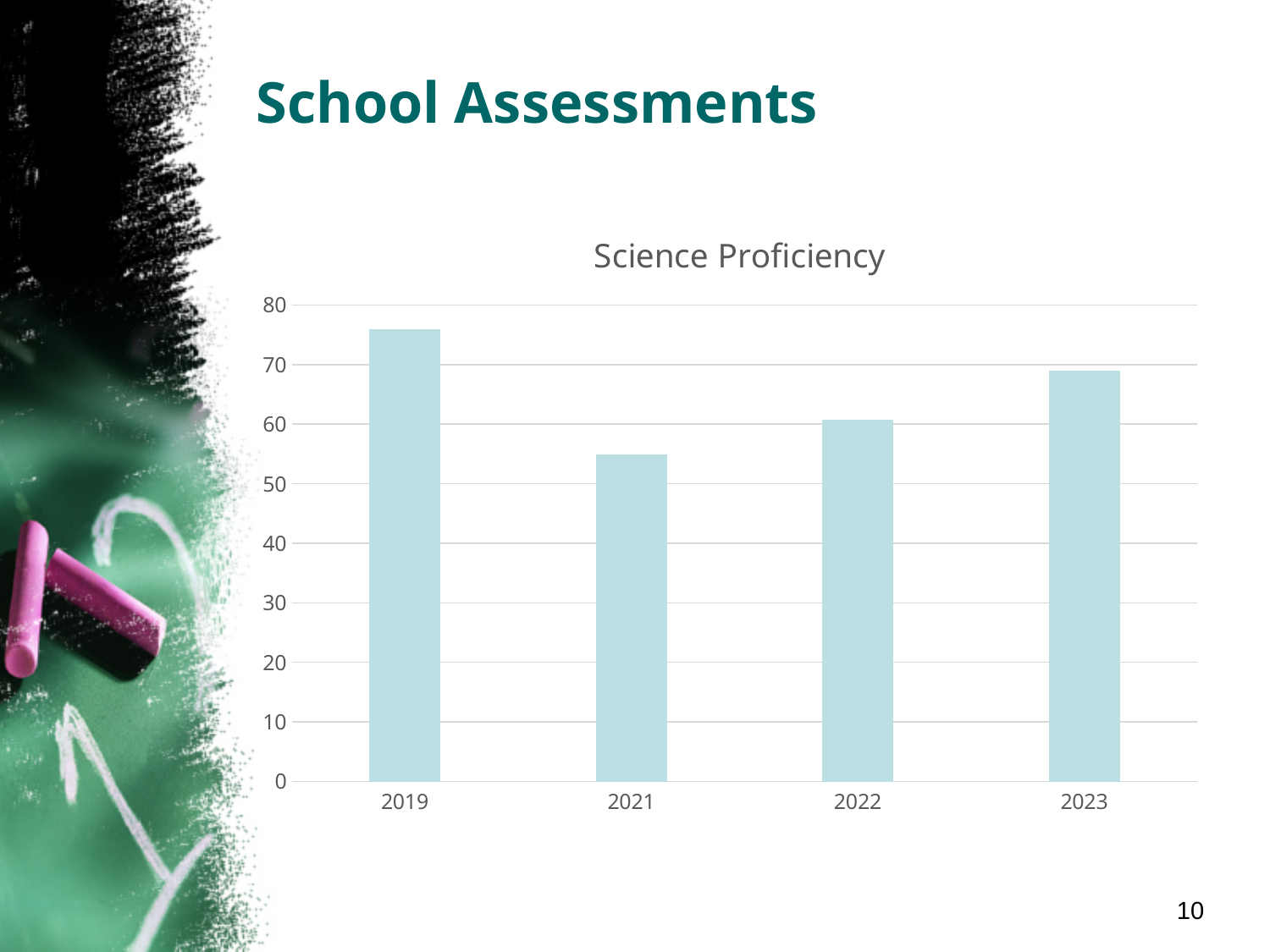
Is the value for 2022 greater or less than 70? less From 2021 to 2023, do the values rise or fall? rise Which is larger, the value for 2019 or the value for 2023? 2019 Is the value for 2019 greater or less than 70? greater What kind of chart is shown on the slide? bar chart Is the value for 2021 greater or less than 60? less Which year has the highest Science Proficiency value? 2019 How many years are shown on the x axis of the chart? 4 What is the title of the chart? Science Proficiency Which year has the lowest Science Proficiency value? 2021 Which is larger, the value for 2021 or the value for 2022? 2022